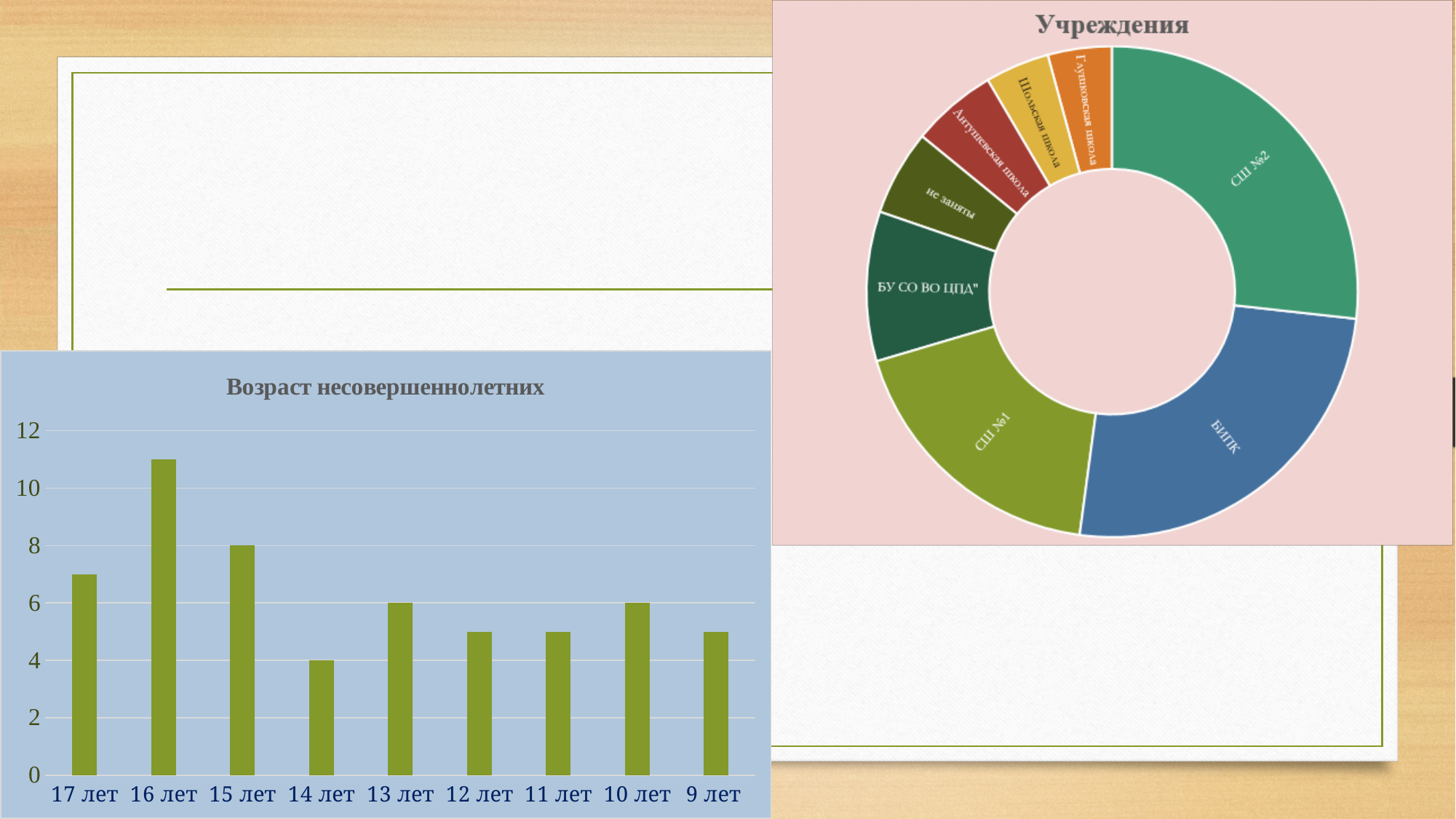
In the 'Учреждения' chart, which slice is larger: СШ №1 or не заняты? СШ №1 In the 'Возраст несовершеннолетних' chart, which is larger: the value for 17 лет or the value for 14 лет? 17 лет In the 'Возраст несовершеннолетних' chart, which age group has the lowest value? 14 лет What kind of chart is the 'Учреждения' chart? doughnut chart In the 'Возраст несовершеннолетних' chart, which age group has the highest value? 16 лет In the 'Возраст несовершеннолетних' chart, what is the value for 15 лет? 8 In the 'Возраст несовершеннолетних' chart, how many age categories are shown on the x axis? 9 In the 'Возраст несовершеннолетних' chart, what is the value for 14 лет? 4 In the 'Возраст несовершеннолетних' chart, is the value for 12 лет greater or less than 6? less In the 'Возраст несовершеннолетних' chart, is the value for 16 лет greater or less than 10? greater In the 'Возраст несовершеннолетних' chart, what is the value for 13 лет? 6 What kind of chart is the 'Возраст несовершеннолетних' chart? bar chart